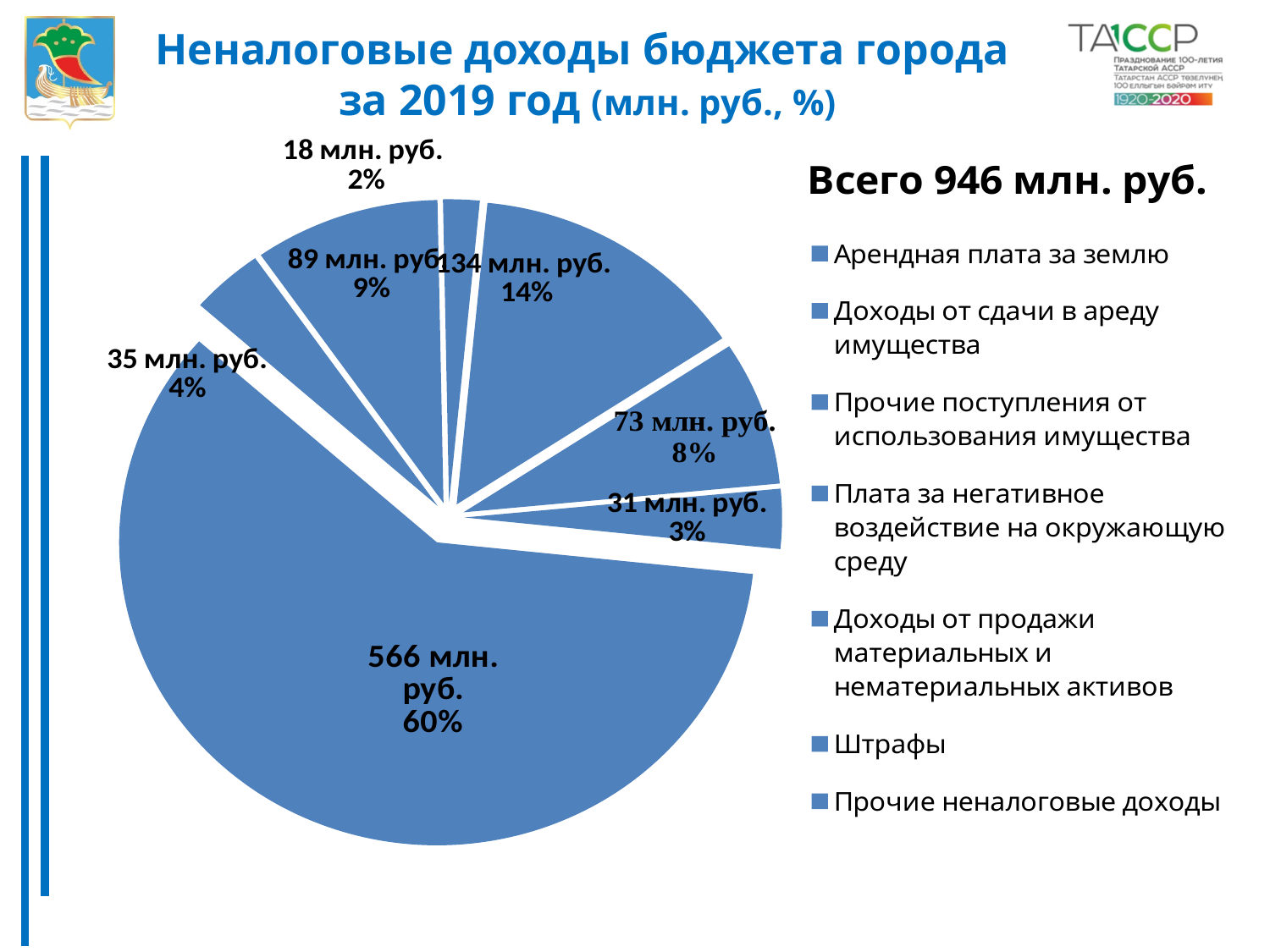
What share of the pie does the slice labelled 134 млн. руб. represent? 14% Which slice is larger: the one labelled 89 млн. руб. or the one labelled 35 млн. руб.? 89 млн. руб. What kind of chart is shown on the slide? pie chart What is the difference between the slice labelled 134 млн. руб. and the slice labelled 73 млн. руб.? 61 млн. руб. What is the value of the smallest slice of the pie chart? 18 млн. руб. What is the value of the largest slice of the pie chart? 566 млн. руб. What is the title of the chart on the slide? Неналоговые доходы бюджета города за 2019 год (млн. руб., %) How many slices does the pie chart have? 7 What share of the pie does the largest slice (566 млн. руб.) represent? 60% What percentage is shown for the slice labelled 73 млн. руб.? 8% What is the total of non-tax revenues stated on the slide? 946 млн. руб. How many entries does the legend of the pie chart list? 7